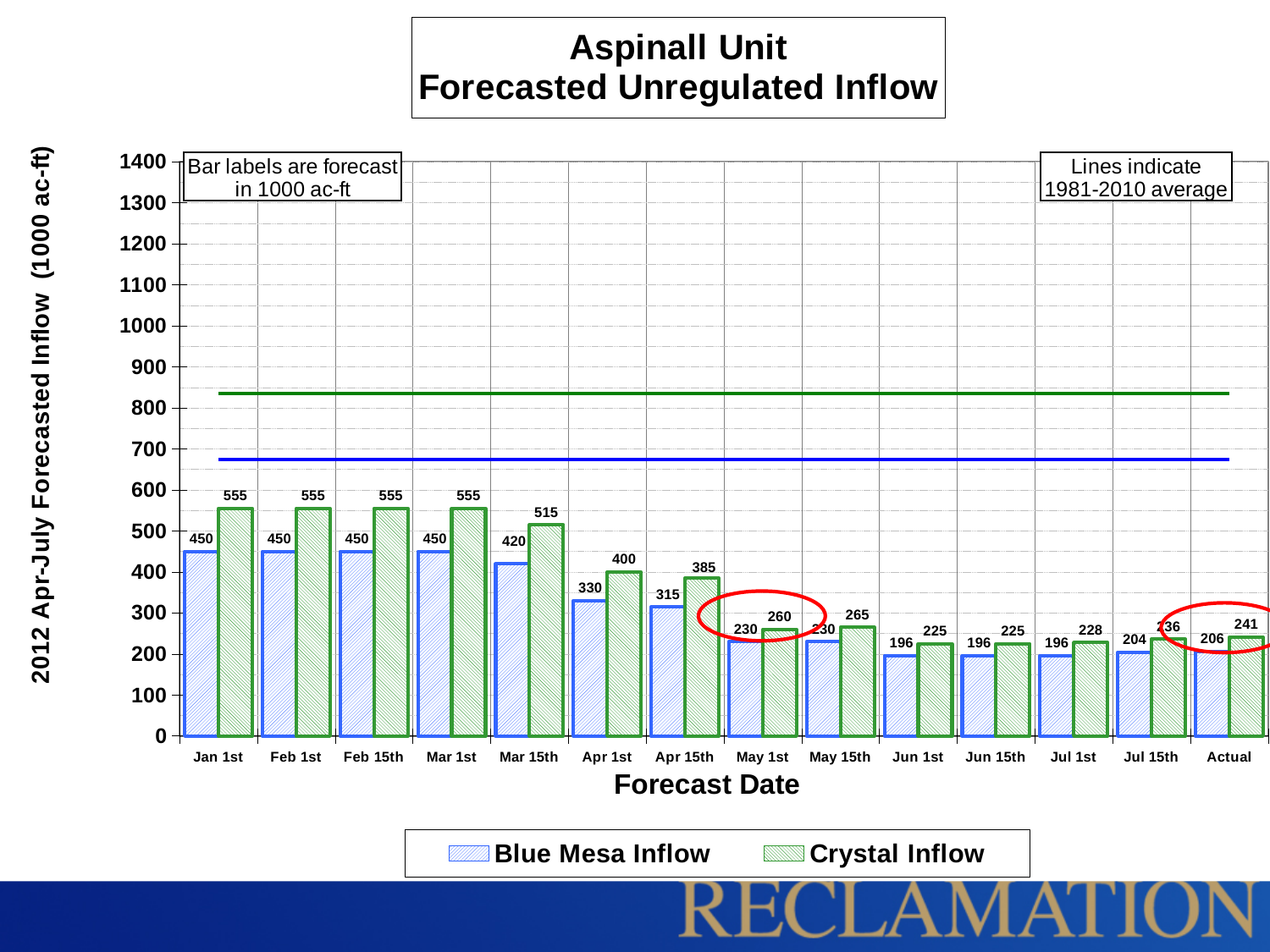
Which has the larger Crystal Inflow forecast, May 1st or May 15th? May 15th Is the green 1981-2010 average line for Crystal Inflow greater or less than 800? greater What kind of chart is shown on the slide? bar chart What is the Crystal Inflow forecast for Apr 1st? 400 What is the Blue Mesa Inflow forecast for Jul 15th? 204 What is the Blue Mesa Inflow forecast for Jan 1st? 450 How many forecast dates are shown on the x axis? 14 What is the difference between the Crystal Inflow and Blue Mesa Inflow forecasts on Mar 15th? 95 What is the Crystal Inflow value for the Actual category? 241 By how much did the Blue Mesa Inflow forecast drop from Apr 1st to Apr 15th? 15 How many series does the legend list? 2 Does the Blue Mesa Inflow forecast rise or fall from Jan 1st to Jul 1st? fall